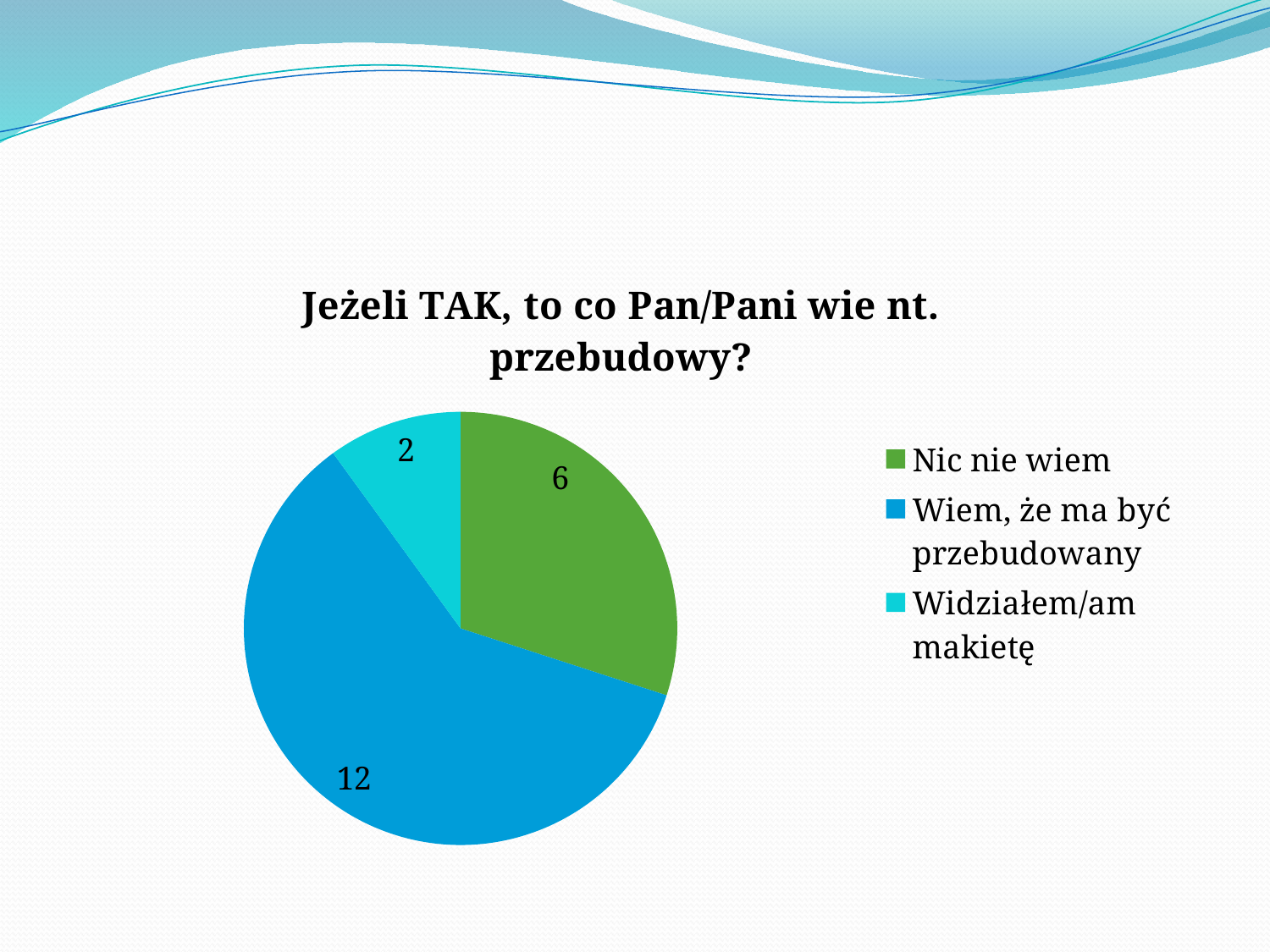
Which category has the largest slice? Wiem, że ma być przebudowany What kind of chart is shown on the slide? pie chart How many categories does the pie chart have? 3 What is the total of all slices in the pie chart? 20 What share of the pie does "Wiem, że ma być przebudowany" represent? 60% What is the value for "Nic nie wiem"? 6 What is the value for "Widziałem/am makietę"? 2 Which category has the smallest slice? Widziałem/am makietę What is the title of the chart? Jeżeli TAK, to co Pan/Pani wie nt. przebudowy? Which is larger: the value for "Nic nie wiem" or the value for "Widziałem/am makietę"? Nic nie wiem What is the difference between the values for "Wiem, że ma być przebudowany" and "Nic nie wiem"? 6 What is the value for "Wiem, że ma być przebudowany"? 12